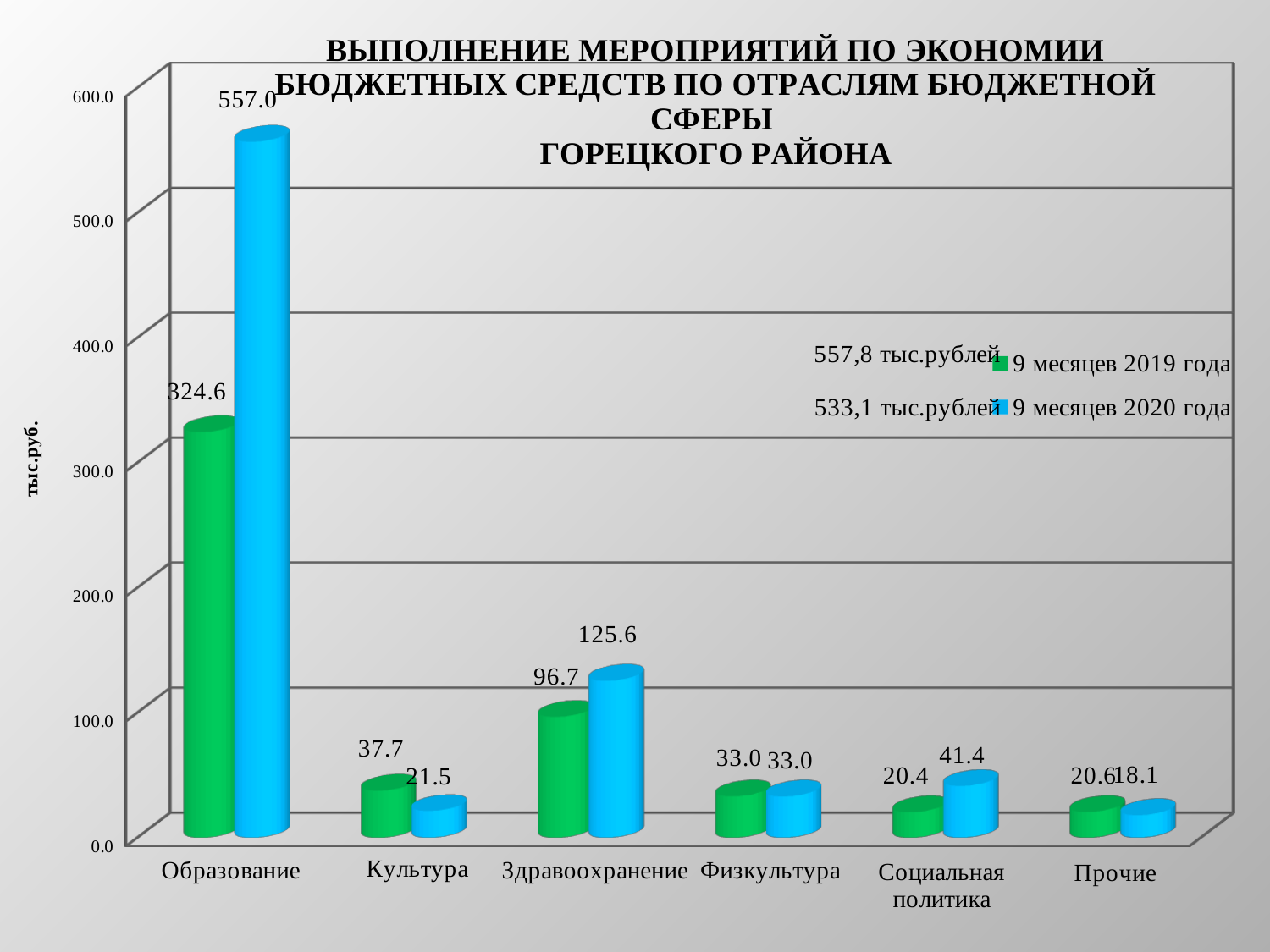
What is the value for Социальная политика in the series 9 месяцев 2020 года? 41.4 Which category has the lowest value in the series 9 месяцев 2020 года? Прочие For Культура, which series has the larger value: 9 месяцев 2019 года or 9 месяцев 2020 года? 9 месяцев 2019 года How many series does the legend list? 2 What type of chart is shown on the slide? Bar chart What is the difference between the 2020 and 2019 values for Здравоохранение? 28.9 Which category has the highest value in the series 9 месяцев 2019 года? Образование What is the value for Образование in the series 9 месяцев 2020 года? 557.0 What unit is shown on the vertical axis label? тыс.руб. How many categories are shown on the x axis? 6 What is the value for Здравоохранение in the series 9 месяцев 2019 года? 96.7 What is the difference between the 2020 and 2019 values for Образование? 232.4